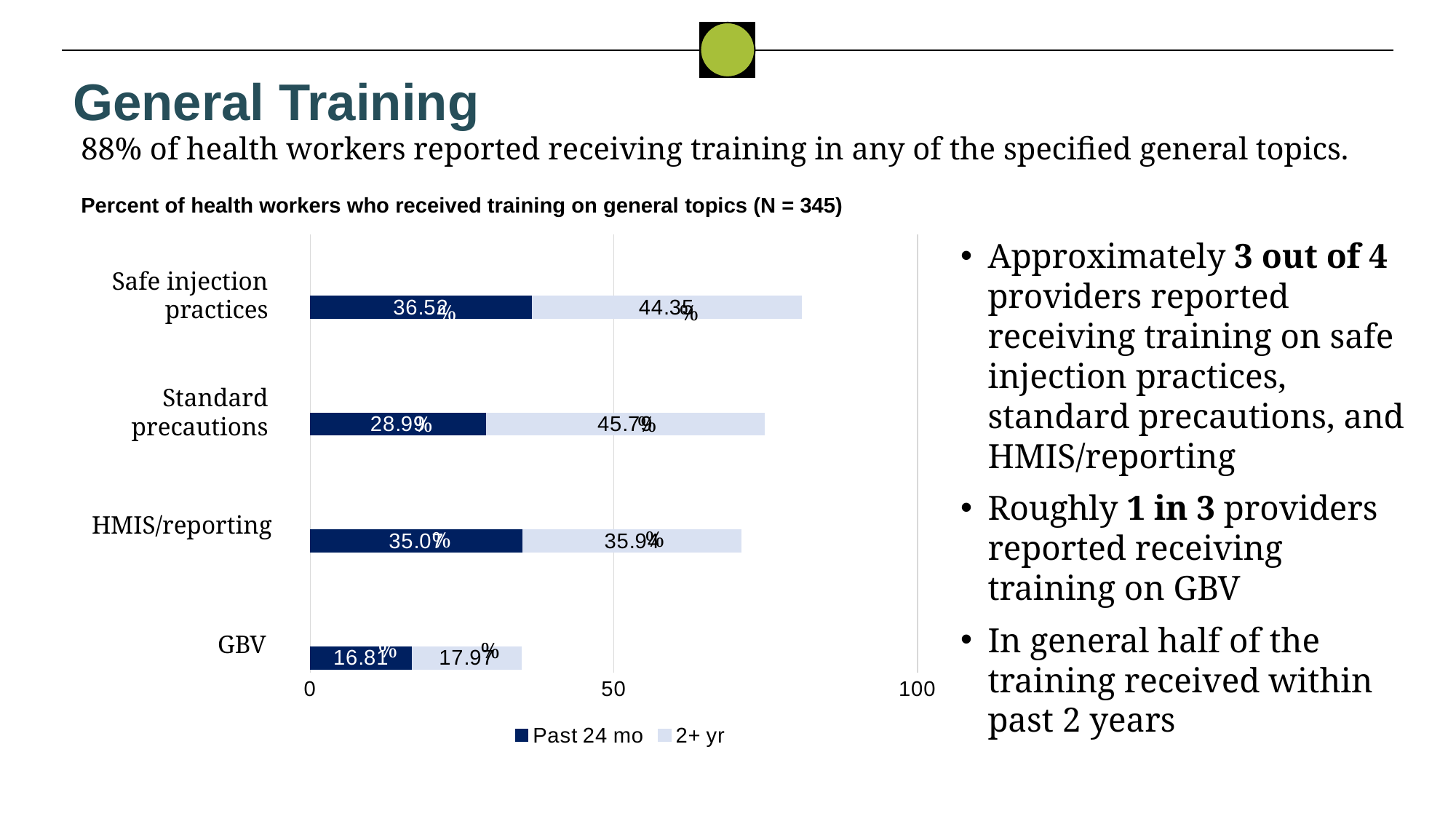
Which topic has the highest Past 24 mo value? Safe injection practices What is the 2+ yr value for HMIS/reporting? 35.9% How many topics are shown on the chart? 4 Which topic has the lowest Past 24 mo value? GBV What is the difference between the 2+ yr and Past 24 mo values for safe injection practices? 7.83 percentage points What is the total of the stacked bar for GBV? 34.71% What is the Past 24 mo value for GBV? 16.81% Which is larger for standard precautions: the Past 24 mo value or the 2+ yr value? 2+ yr What percent of health workers received training on safe injection practices in the past 24 months? 36.52% How many series does the legend list? 2 What is the 2+ yr value for standard precautions? 45.7% What kind of chart is shown on the slide? Stacked bar chart